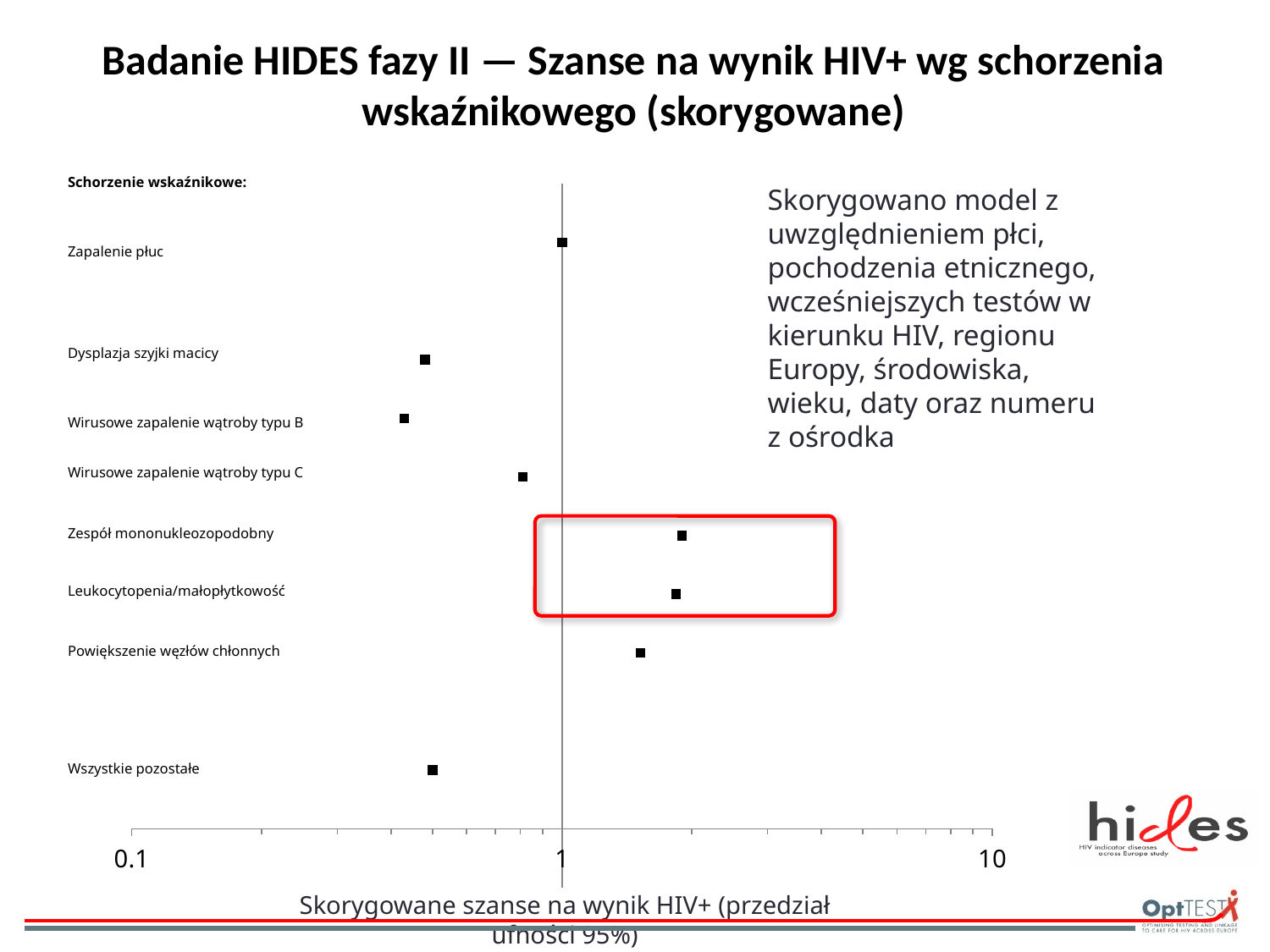
How many indicator conditions (categories) are plotted on the chart? 8 Is the value for Wszystkie pozostałe greater or less than 1? less Is the value for Dysplazja szyjki macicy greater or less than 1? less Which has the larger value: Wirusowe zapalenie wątroby typu B or Wirusowe zapalenie wątroby typu C? Wirusowe zapalenie wątroby typu C Is the value for Leukocytopenia/małopłytkowość greater or less than 1? greater Which has the larger value: Zespół mononukleozopodobny or Powiększenie węzłów chłonnych? Zespół mononukleozopodobny What is the label of the x axis? Skorygowane szanse na wynik HIV+ (przedział ufności 95%) What kind of chart is shown on the slide? Scatter (dot) plot What are the tick values shown on the x axis? 0.1, 1, 10